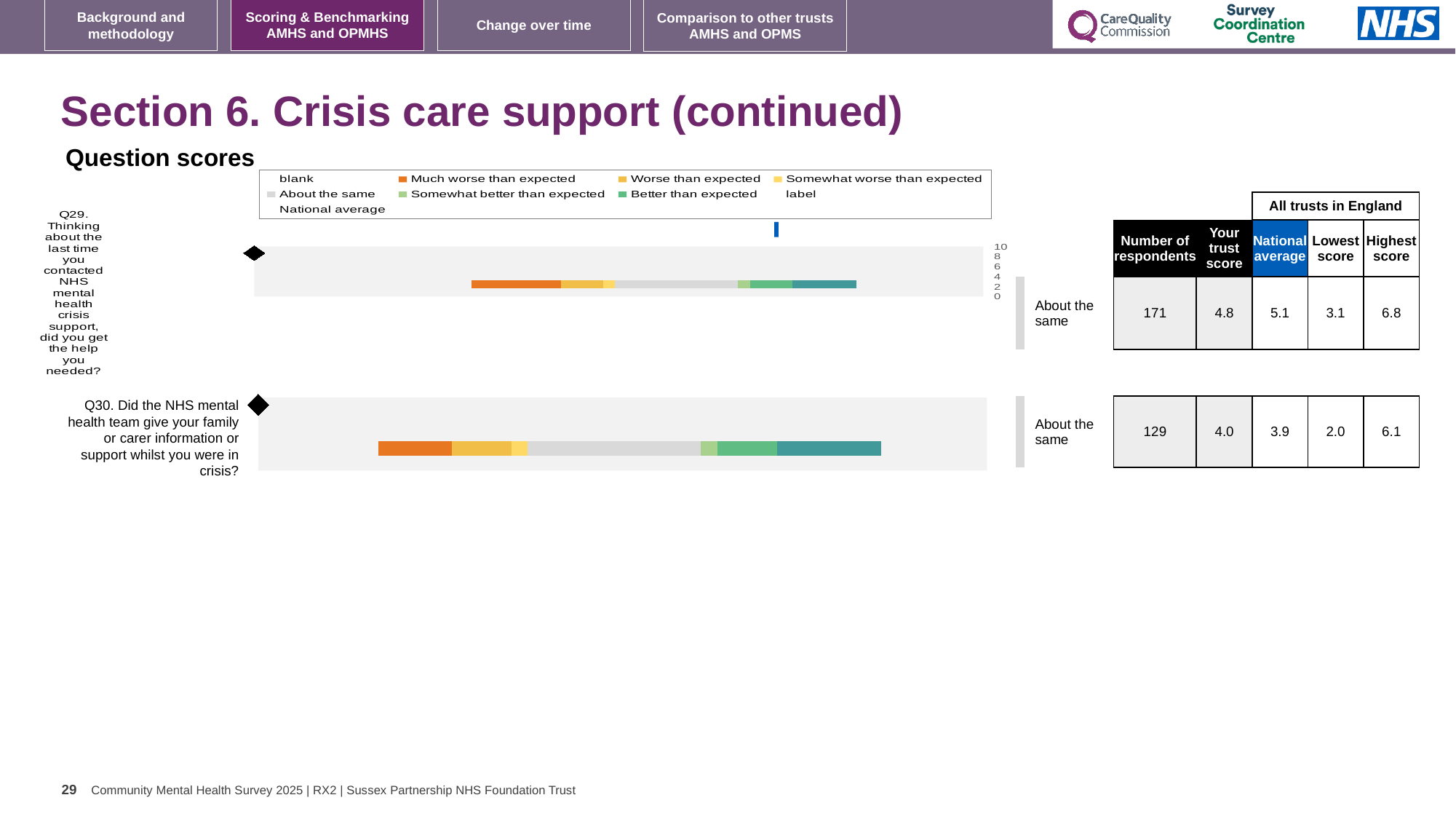
What is the trust score for Q29? 4.8 What kind of chart is used to show the question scores for Q29 and Q30? bar chart How many respondents answered Q30? 129 How many questions are plotted on the slide? 2 What is the national average for Q30? 3.9 What is the highest score among all trusts in England for Q29? 6.8 Which question had more respondents, Q29 or Q30? Q29 What is the lowest score among all trusts in England for Q30? 2.0 What is the difference between the highest and lowest scores for Q29? 3.7 For Q29, which is larger: the trust score or the national average? national average For Q30, which is larger: the trust score or the national average? trust score Which legend category is shown in orange? Much worse than expected